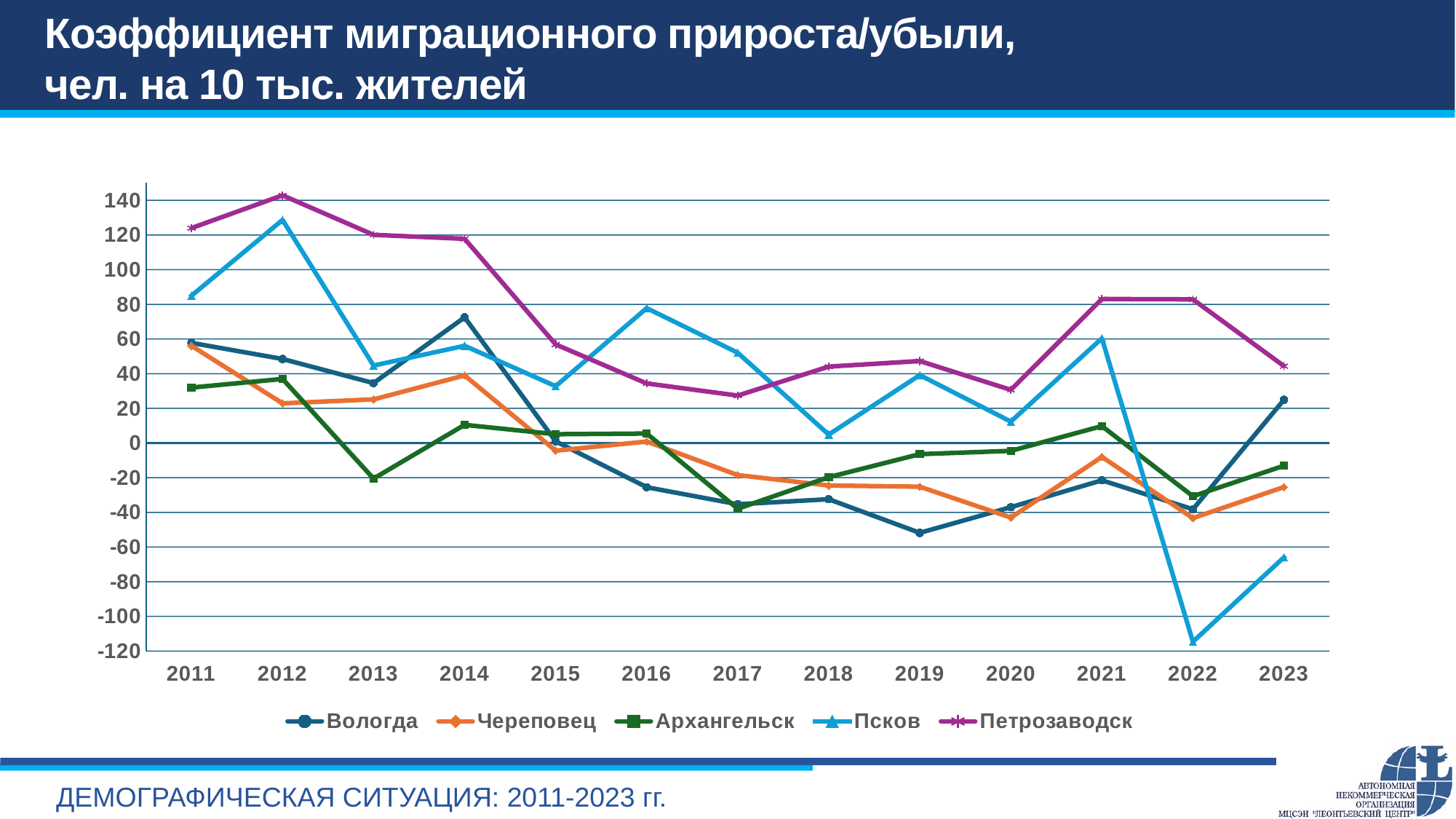
How many years are shown on the x axis? 13 Which city has the lowest value in 2022? Псков Is the value for Архангельск in 2013 greater or less than 0? less Is the value for Петрозаводск in 2011 greater or less than 100? greater Is the value for Псков in 2022 greater or less than -100? less In 2021, which is larger: the value for Псков or for Петрозаводск? Петрозаводск Which city has the highest value in 2012? Петрозаводск Does the value for Петрозаводск rise or fall from 2012 to 2015? fall How many series does the legend list? 5 What kind of chart is shown on the slide? line chart In 2014, which is larger: the value for Вологда or for Череповец? Вологда